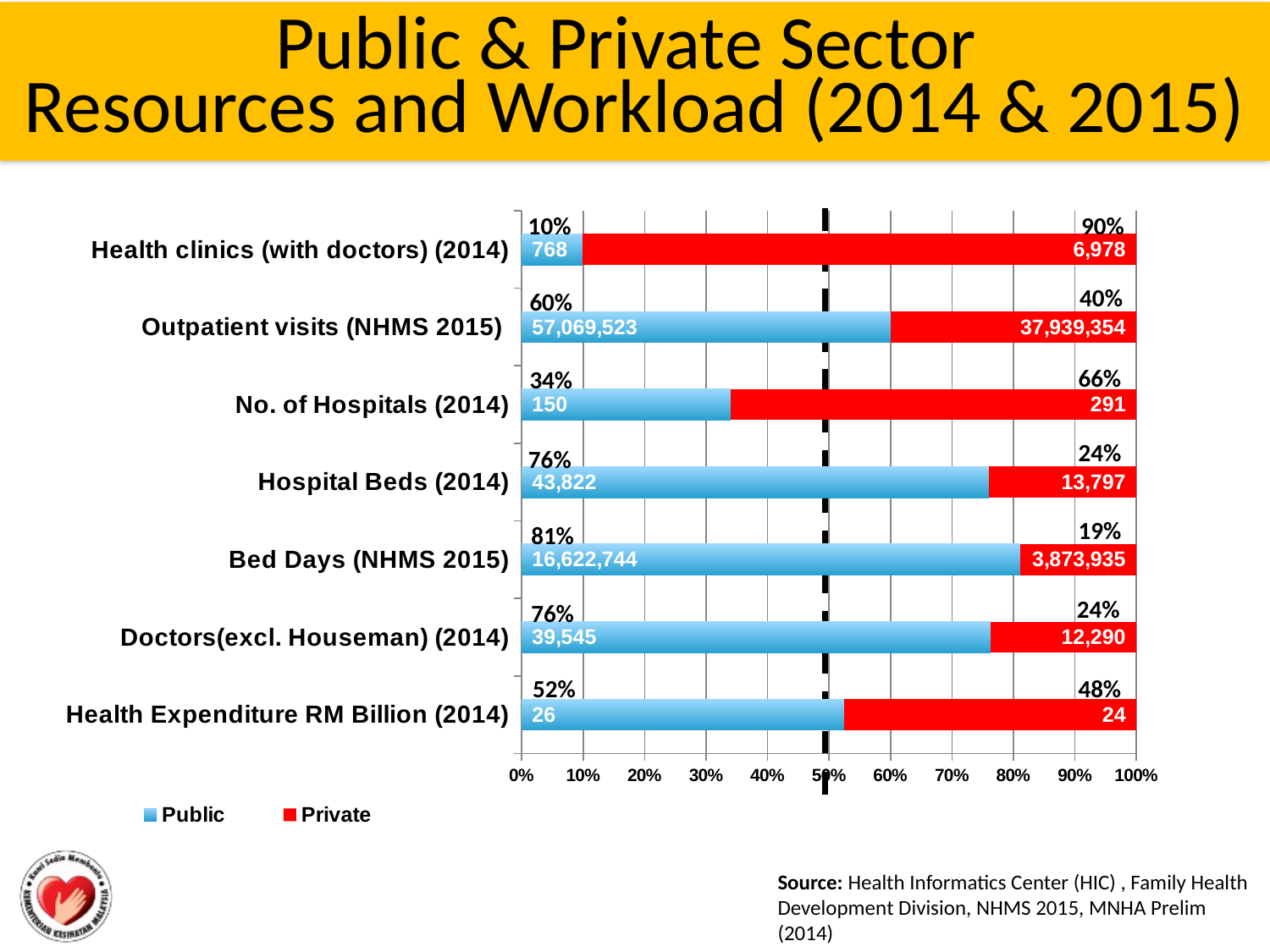
What is the difference between the Public and Private values for Hospital Beds (2014)? 30,025 What is the total of the Public and Private values for Health Expenditure RM Billion (2014)? 50 Which category has the highest Public percentage share? Bed Days (NHMS 2015) What is the difference between the Private and Public values for No. of Hospitals (2014)? 141 How many categories are shown on the chart? 7 What kind of chart is shown on the slide? Stacked bar chart What is the Public value for Outpatient visits (NHMS 2015)? 57,069,523 What is the Public value for Hospital Beds (2014)? 43,822 How many series does the legend list? 2 Which category has the lowest Public percentage share? Health clinics (with doctors) (2014) For Doctors(excl. Houseman) (2014), which is larger, the Public or the Private value? Public What percentage share does the Private sector have for No. of Hospitals (2014)? 66%